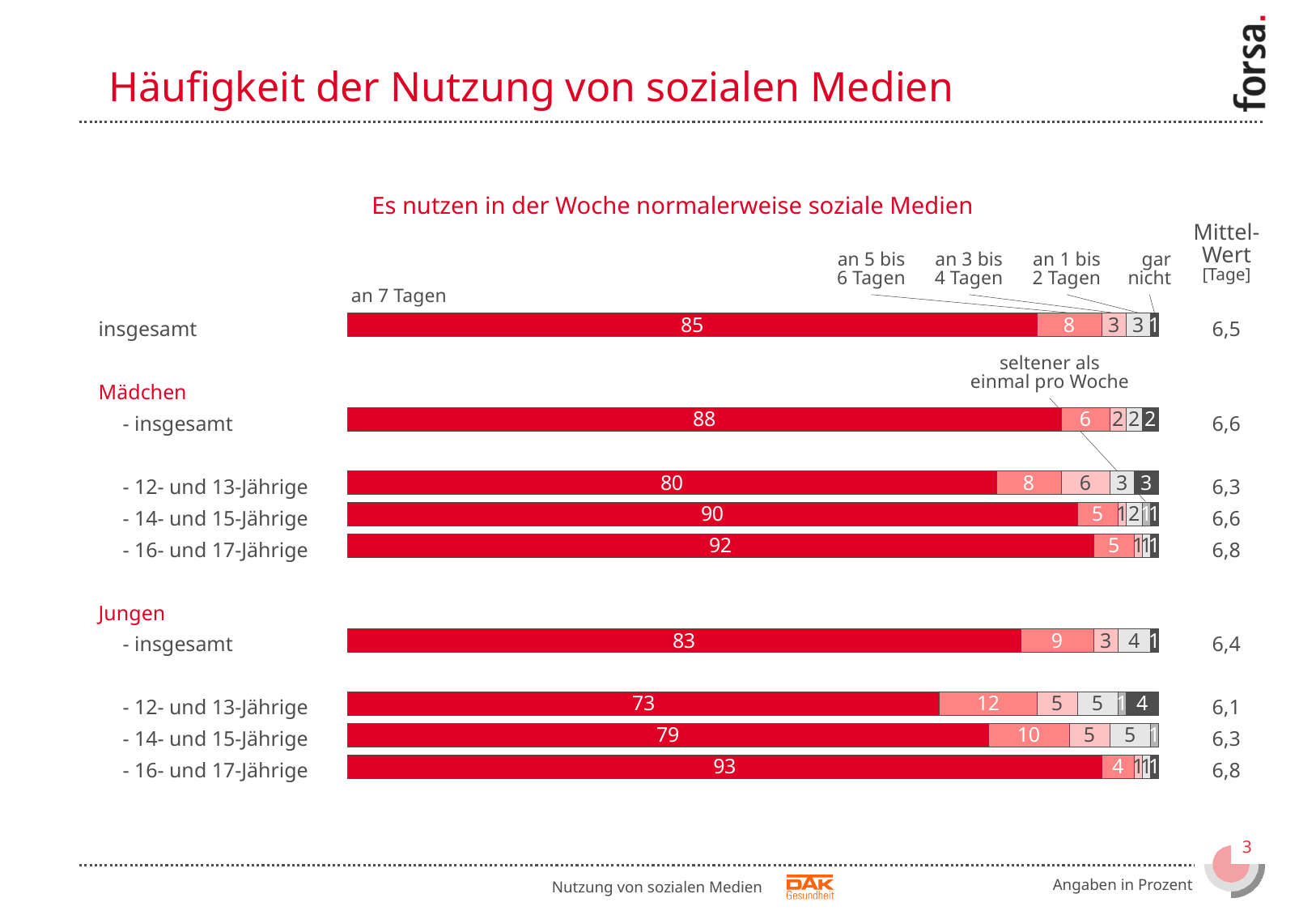
How many groups (bars) are shown in the chart? 9 Which group has the lowest share using social media 'an 7 Tagen'? Jungen, 12- und 13-Jährige What is the Mittelwert [Tage] for the 12- und 13-Jährige Jungen? 6,1 What is the Mittelwert [Tage] for the 16- und 17-Jährige Mädchen? 6,8 What is the difference in the 'an 7 Tagen' share between Mädchen insgesamt and Jungen insgesamt? 5 Among the 12- und 13-Jährige, who has the larger 'an 7 Tagen' share: Mädchen or Jungen? Mädchen What is the subtitle printed above the chart? Es nutzen in der Woche normalerweise soziale Medien What percentage of the 14- und 15-Jährige Jungen use social media 'an 5 bis 6 Tagen'? 10 What type of chart is shown on the slide? Stacked bar chart Which group has the highest share using social media 'an 7 Tagen'? Jungen, 16- und 17-Jährige What percentage of the 12- und 13-Jährige Jungen use social media 'an 5 bis 6 Tagen'? 12 What percentage of all respondents (insgesamt) use social media 'an 7 Tagen'? 85